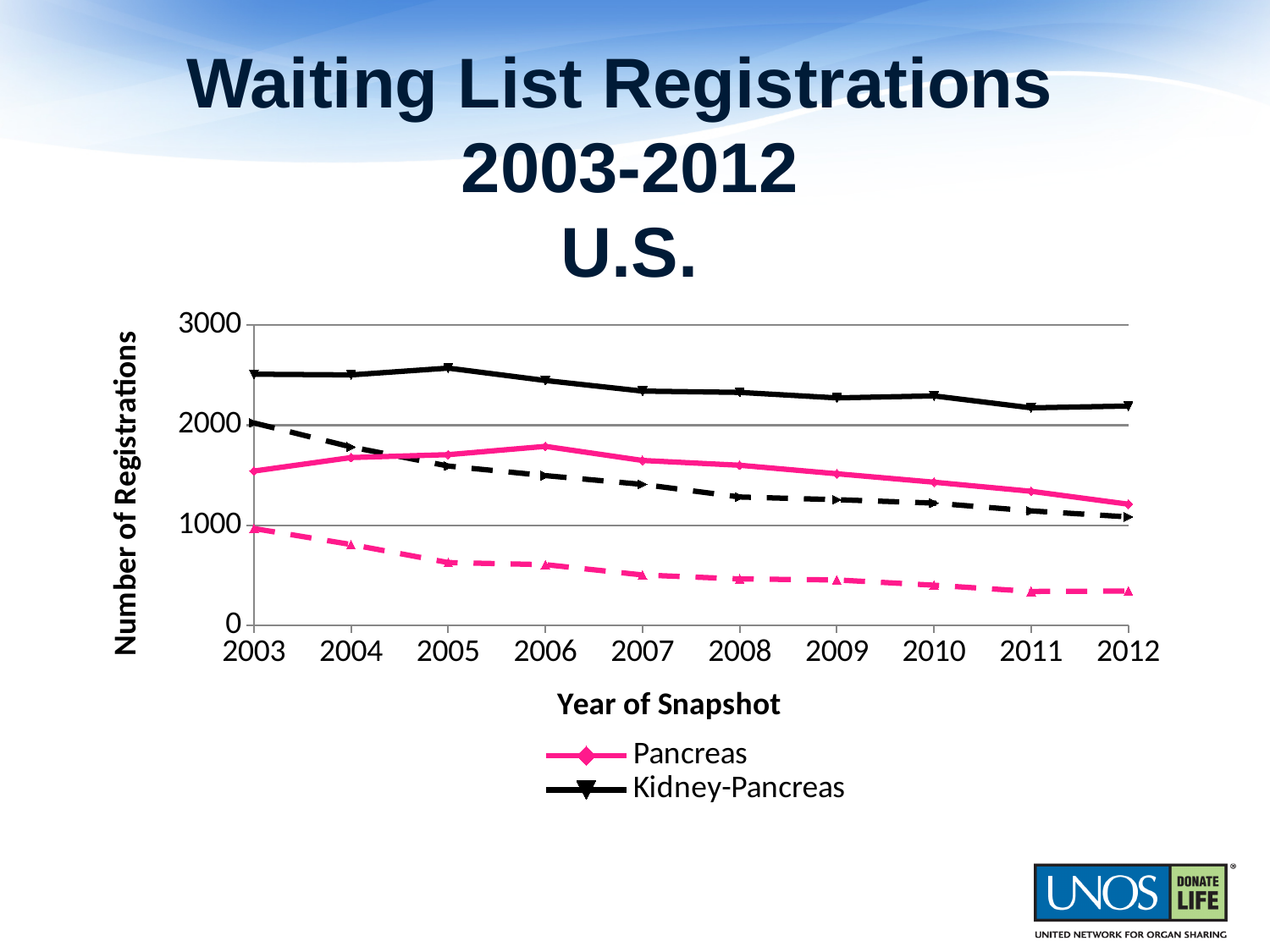
In which year does the Pancreas series reach its lowest value? 2012 Is the Kidney-Pancreas value for 2005 greater or less than 2000? greater What kind of chart is shown on the slide? line chart How many years are plotted along the x axis? 10 How many series does the legend list? 2 What is the title of the x axis? Year of Snapshot Overall, does the Kidney-Pancreas series rise or fall from 2003 to 2012? fall In 2008, which series has the larger value, Pancreas or Kidney-Pancreas? Kidney-Pancreas In which year does the Pancreas series reach its highest value? 2006 Is the Pancreas value for 2006 greater or less than 2000? less Is the Kidney-Pancreas value for 2012 greater or less than 2000? greater